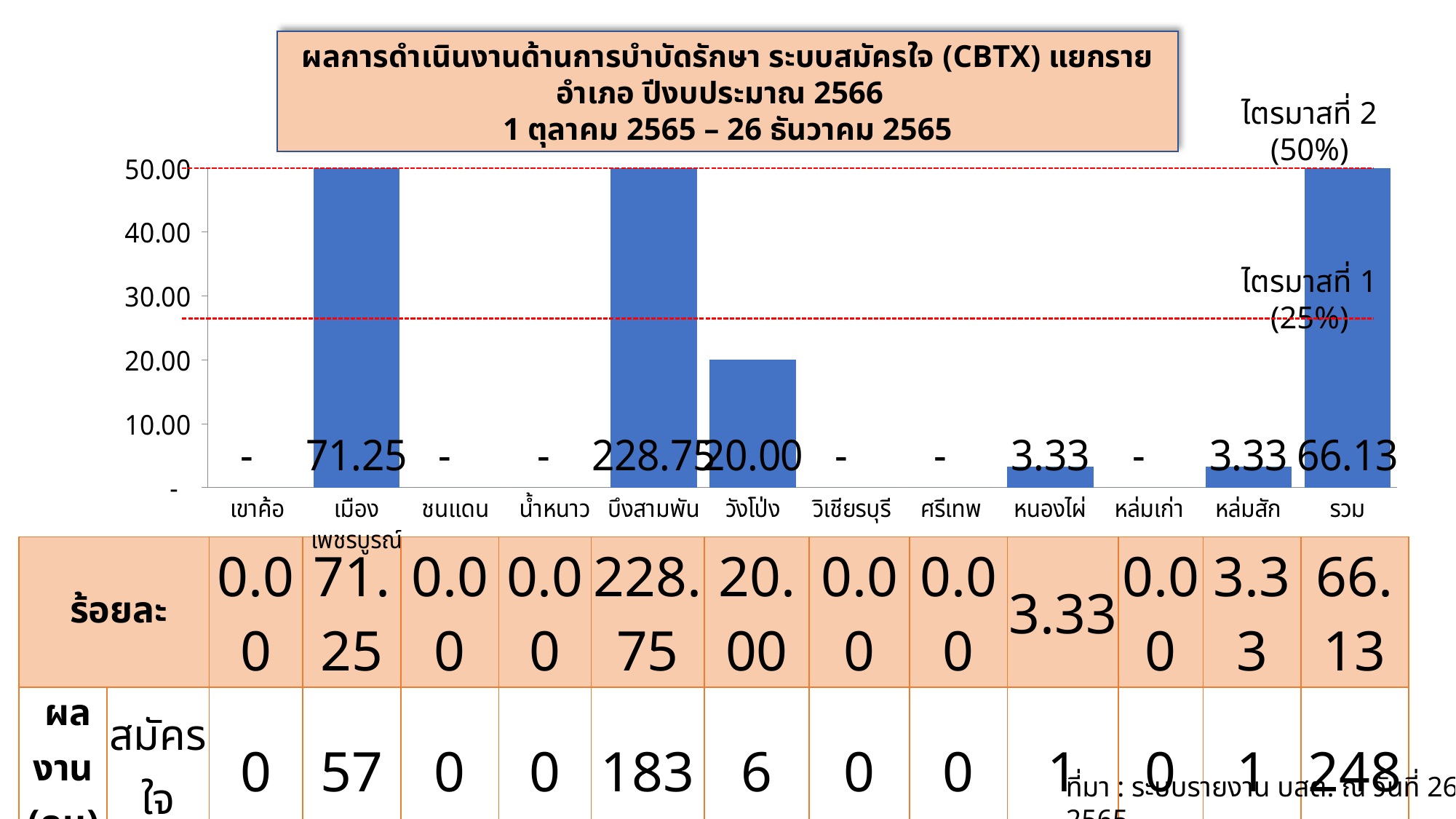
What percentage is labelled on the upper dashed reference line (ไตรมาสที่ 2)? 50% What is the value shown for วังโป่ง? 20.00 How many categories are shown on the x axis of the chart? 12 Which is larger, the value for วังโป่ง or the value for หล่มสัก? วังโป่ง What is the value shown for เมืองเพชรบูรณ์? 71.25 What is the difference between the values for เมืองเพชรบูรณ์ and วังโป่ง? 51.25 What is the difference between the values for บึงสามพัน and เมืองเพชรบูรณ์? 157.50 What is the value shown for หนองไผ่? 3.33 Which category has the highest value in the chart? บึงสามพัน What type of chart is shown on the slide? bar chart What is the value shown for บึงสามพัน? 228.75 What is the value shown for รวม? 66.13